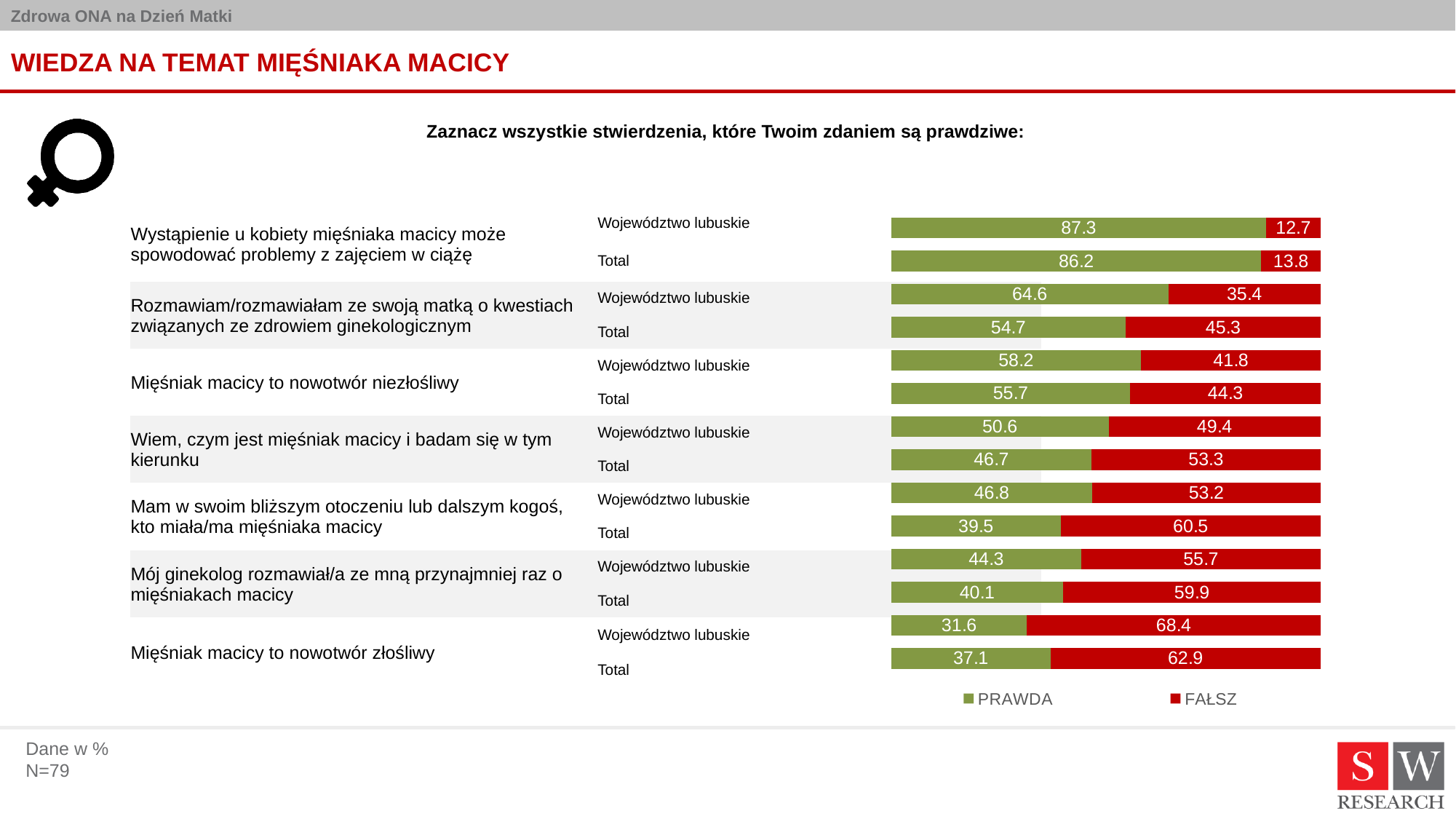
Which colour represents the FAŁSZ series in the chart? Red Which statement has the highest PRAWDA value for "Województwo lubuskie"? Wystąpienie u kobiety mięśniaka macicy może spowodować problemy z zajęciem w ciążę How many series does the legend list? 2 What is the PRAWDA value for "Województwo lubuskie" for the statement "Wystąpienie u kobiety mięśniaka macicy może spowodować problemy z zajęciem w ciążę"? 87.3 Which statement has the lowest PRAWDA value for "Województwo lubuskie"? Mięśniak macicy to nowotwór złośliwy What is the difference between the PRAWDA values for "Województwo lubuskie" and "Total" for the statement "Rozmawiam/rozmawiałam ze swoją matką o kwestiach związanych ze zdrowiem ginekologicznym"? 9.9 How many statements are shown in the chart? 7 For the statement "Mięśniak macicy to nowotwór niezłośliwy", which is larger: the PRAWDA value for "Województwo lubuskie" or for "Total"? Województwo lubuskie What is the FAŁSZ value for "Total" for the statement "Mięśniak macicy to nowotwór złośliwy"? 62.9 What is the total of the stacked bar for "Total" for the statement "Wiem, czym jest mięśniak macicy i badam się w tym kierunku"? 100 What is the PRAWDA value for "Total" for the statement "Mój ginekolog rozmawiał/a ze mną przynajmniej raz o mięśniakach macicy"? 40.1 What kind of chart is shown on the slide? Stacked bar chart